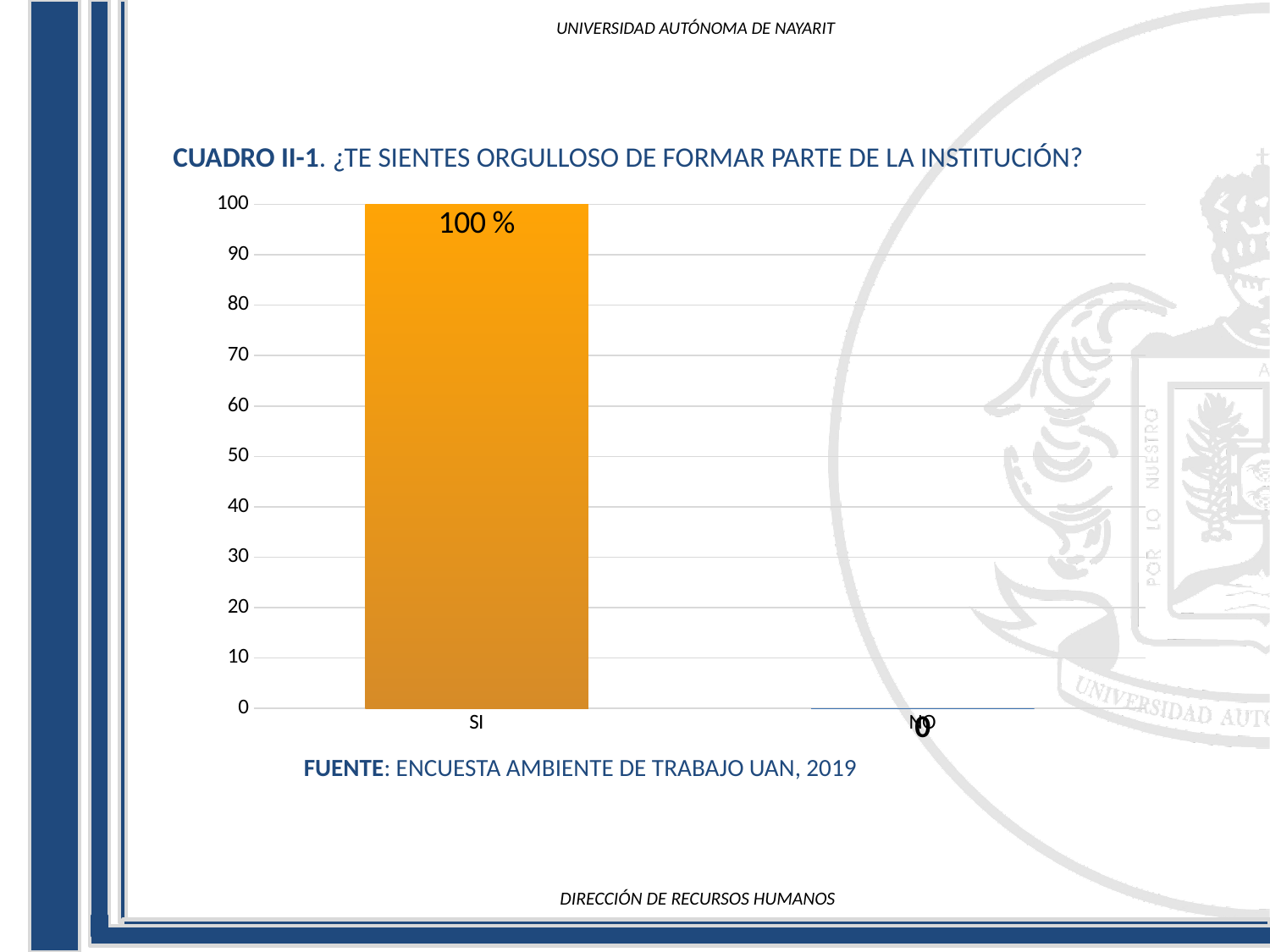
Is the value for SI greater or less than 50? greater What is the value shown for SI? 100 % Which category has the highest value? SI What is the highest value shown on the vertical axis? 100 Which category has the lowest value? NO What is the difference between the value for SI and the value for NO? 100 What kind of chart is shown on the slide? bar chart Which is larger, the value for SI or the value for NO? SI How many categories are shown on the x axis? 2 What is the value shown for NO? 0 What is the source cited below the chart? ENCUESTA AMBIENTE DE TRABAJO UAN, 2019